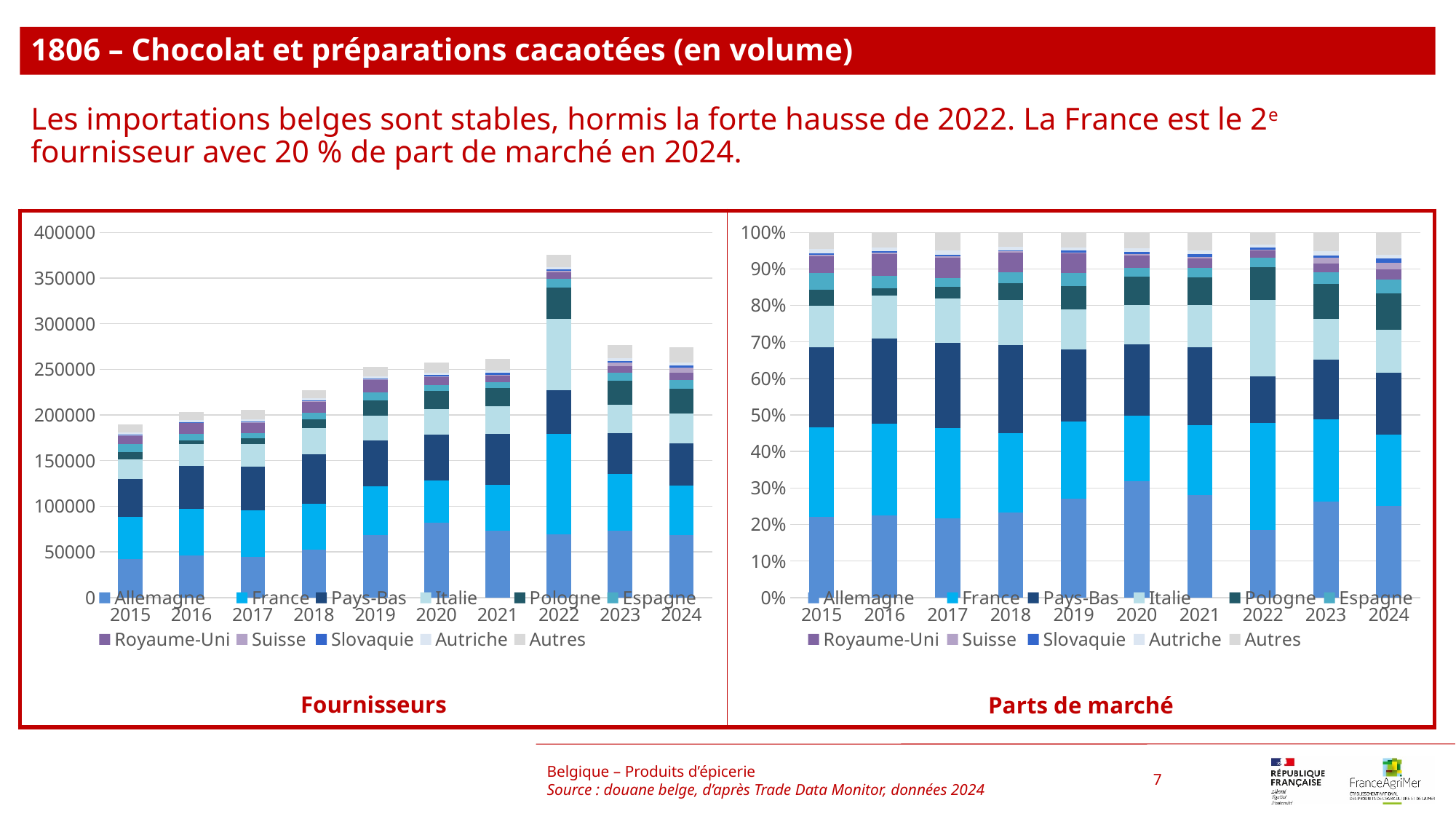
How many years are shown on the x axis of the 'Parts de marché' chart? 10 Which series is shown at the bottom of each stacked bar in the 'Parts de marché' chart? Allemagne In the 'Fournisseurs' chart, which year has the shortest stacked bar? 2015 In the 'Parts de marché' chart, what is the total of the stacked bar for 2024? 100% In the 'Fournisseurs' chart, which year has the larger total, 2022 or 2023? 2022 In the 'Fournisseurs' chart, do the stacked totals rise or fall from 2015 to 2021? rise In the 'Fournisseurs' chart, which year has the tallest stacked bar? 2022 How many series does the legend of the 'Fournisseurs' chart list? 11 In the 'Fournisseurs' chart, is the total for 2015 greater or less than 200000? less In the 'Parts de marché' chart, is the share for Allemagne in 2024 greater or less than 30%? less What kind of chart is the 'Fournisseurs' chart on the left? Stacked bar chart In the 'Fournisseurs' chart, is the total for 2022 greater or less than 350000? greater